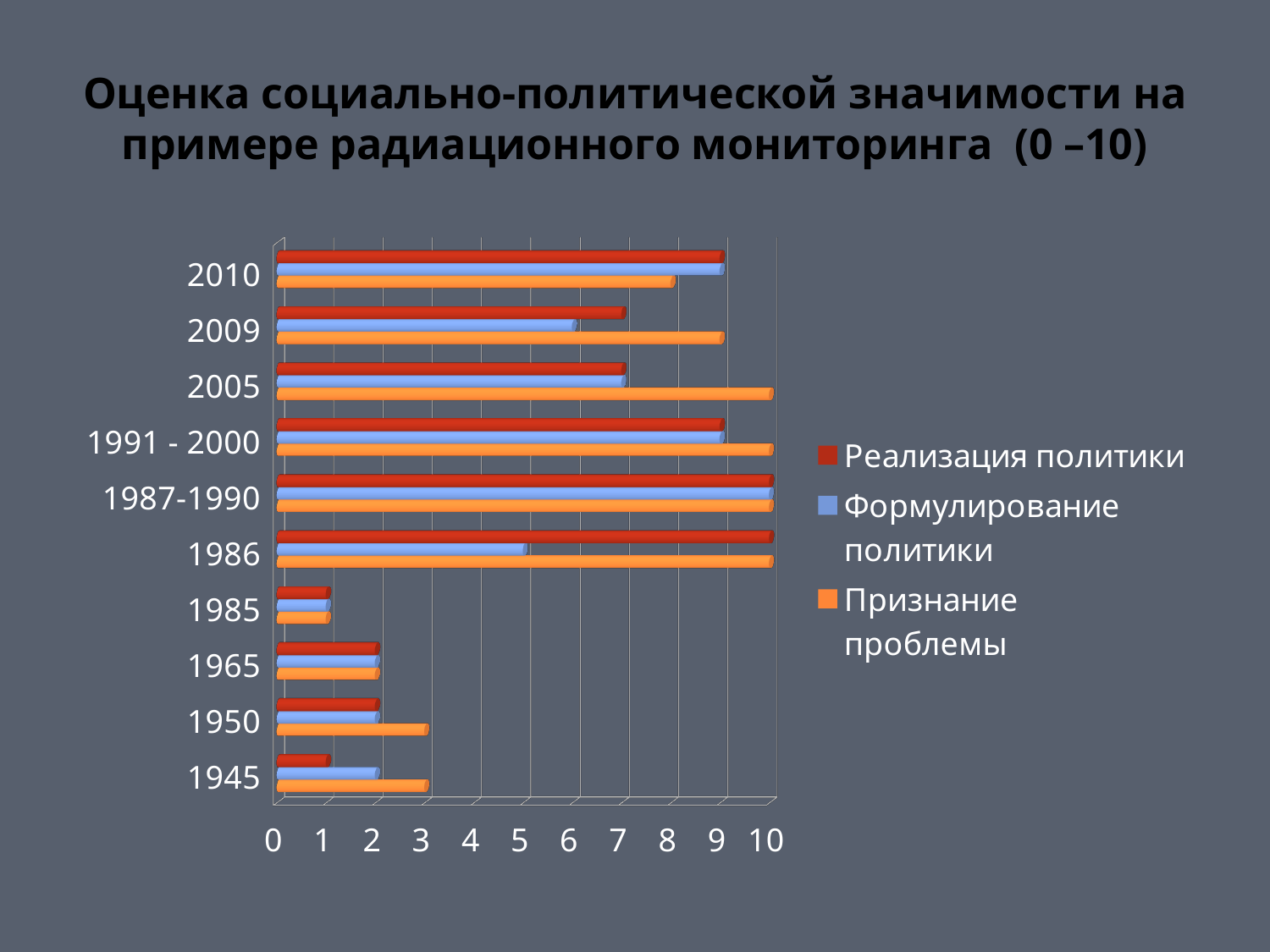
Which colour represents the series Признание проблемы in the legend? orange What is the difference between Признание проблемы and Формулирование политики for 1986? 5 What is the value of Признание проблемы for 2010? 8 How many series does the legend list? 3 Is the value of Реализация политики for 1991 - 2000 greater or less than 5? greater What kind of chart is shown on the slide? bar chart What is the value of Признание проблемы for 2005? 10 For 2009, which is larger: Реализация политики or Признание проблемы? Признание проблемы Which category has the lowest value for Признание проблемы? 1985 Is the value of Формулирование политики for 2009 greater or less than 8? less What is the value of Формулирование политики for 1986? 5 How many categories (time periods) are shown on the vertical axis? 10